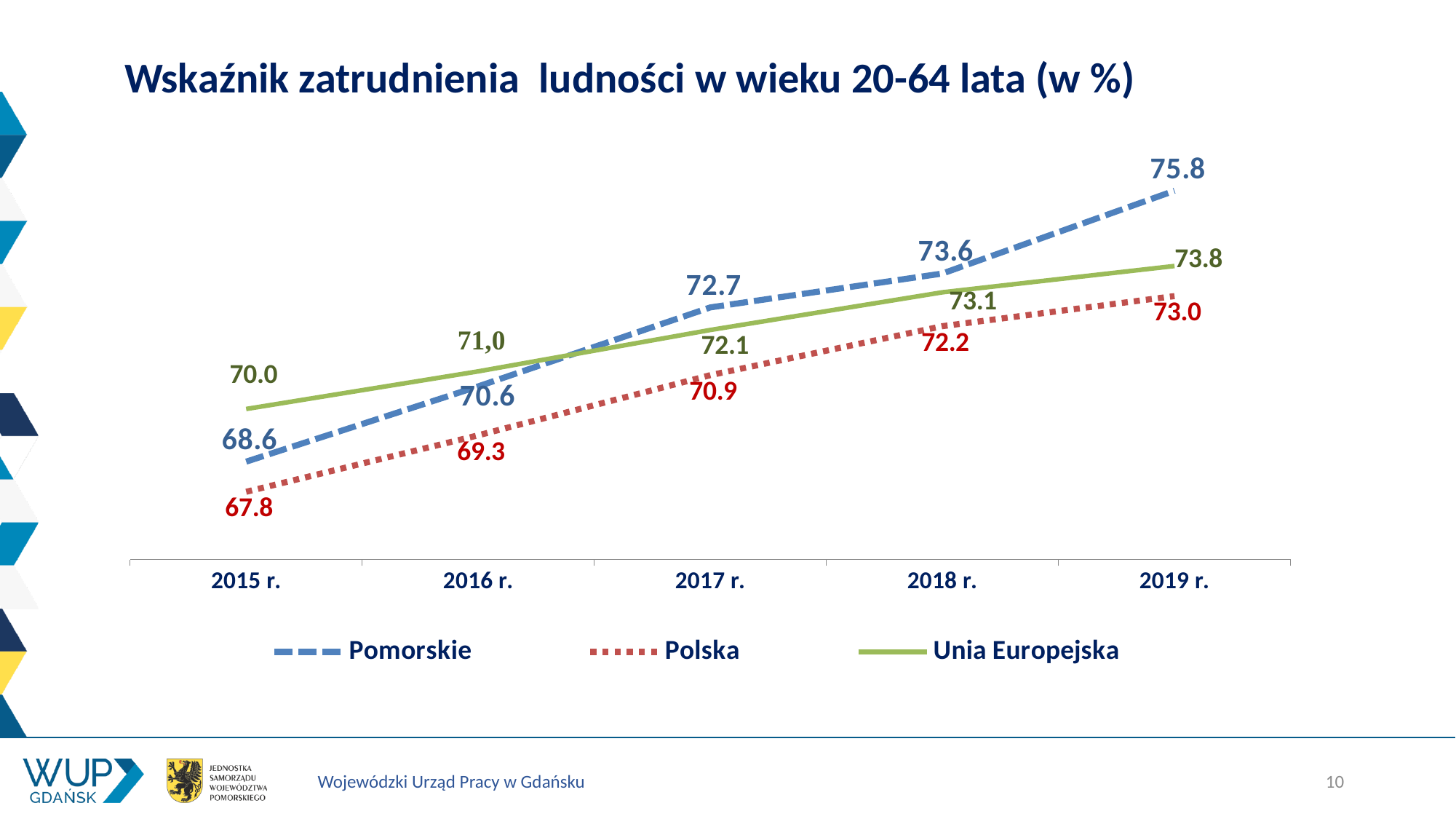
How many years are shown on the x axis? 5 In which year is the value for Pomorskie the highest? 2019 r. Which is larger in 2015 r., the value for Pomorskie or for Unia Europejska? Unia Europejska How many series does the legend list? 3 What is the value for Pomorskie in 2019 r.? 75.8 What is the value for Polska in 2015 r.? 67.8 What is the value for Polska in 2018 r.? 72.2 Does the value for Pomorskie rise or fall from 2015 r. to 2019 r.? rise What is the difference between the Pomorskie and Polska values in 2019 r.? 2.8 What is the value for Unia Europejska in 2016 r.? 71,0 In which year is the value for Polska the lowest? 2015 r. What type of chart is shown on the slide? line chart